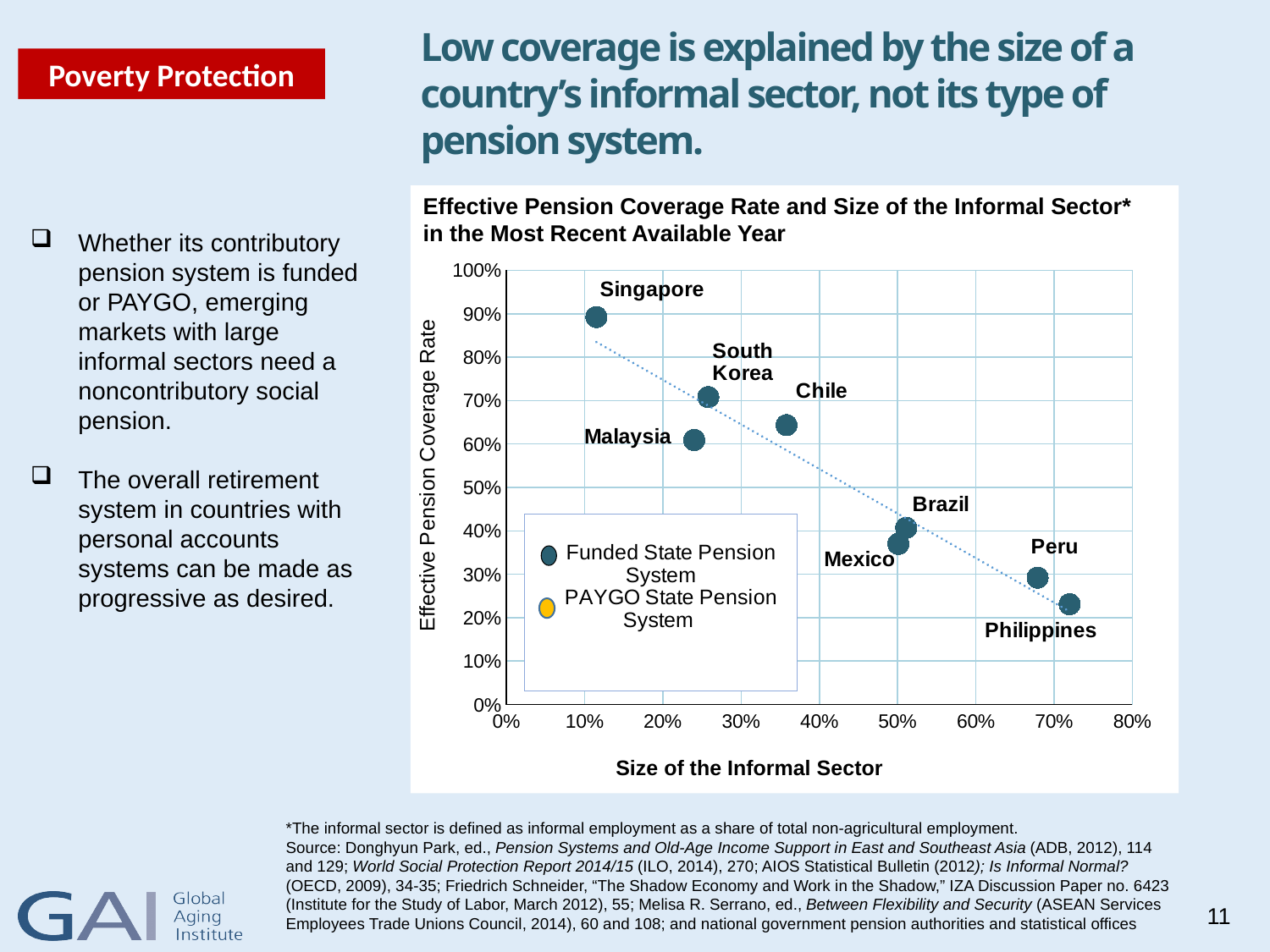
Which has a higher effective pension coverage rate, South Korea or Malaysia? South Korea Is the effective pension coverage rate for Singapore greater or less than 80%? greater Which country has the highest effective pension coverage rate? Singapore Is the effective pension coverage rate for Brazil greater or less than 50%? less Is the size of the informal sector for Peru greater or less than 60%? greater What kind of chart is shown on the slide? Scatter chart Which country has the smallest informal sector? Singapore What is the label of the x axis? Size of the Informal Sector As the size of the informal sector increases along the x axis, does the effective pension coverage rate rise or fall? fall How many series does the legend list? 2 How many countries are labelled on the chart? 8 Which country has the lowest effective pension coverage rate? Philippines